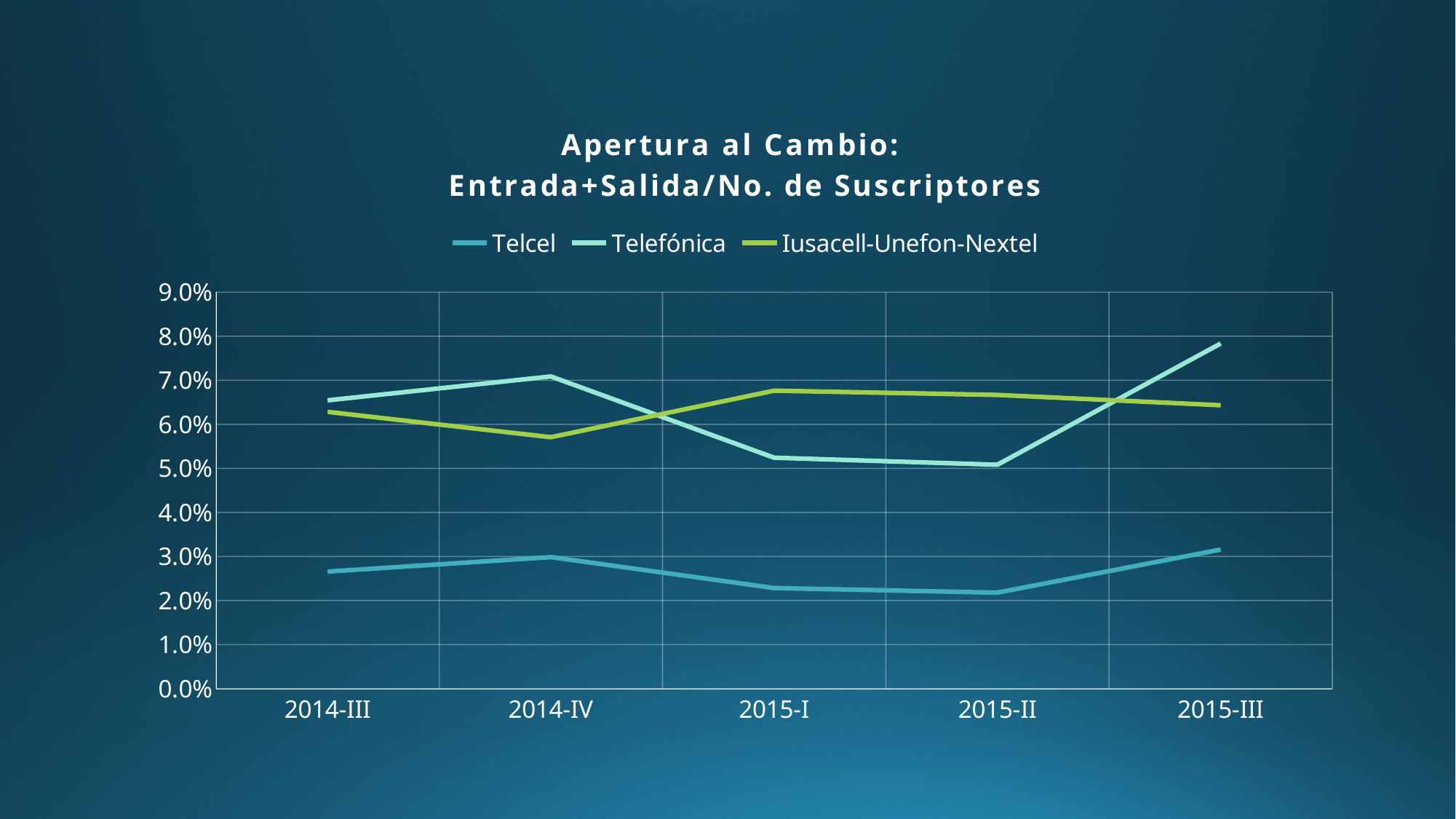
Does the Telefónica line rise or fall from 2015-II to 2015-III? rise How many periods are shown on the x axis? 5 Which series has the lowest values across all periods? Telcel What is the title of the chart? Apertura al Cambio: Entrada+Salida/No. de Suscriptores What kind of chart is shown on the slide? line chart Is the value for Iusacell-Unefon-Nextel in 2014-IV greater or less than 6.0%? less Is the value for Telcel in 2015-II greater or less than 3.0%? less In which period does Telcel reach its lowest value? 2015-II In which period does Telefónica reach its highest value? 2015-III In 2015-I, which is larger: the value for Telefónica or the value for Iusacell-Unefon-Nextel? Iusacell-Unefon-Nextel Is the value for Telefónica in 2015-III greater or less than 7.0%? greater How many series does the legend list? 3